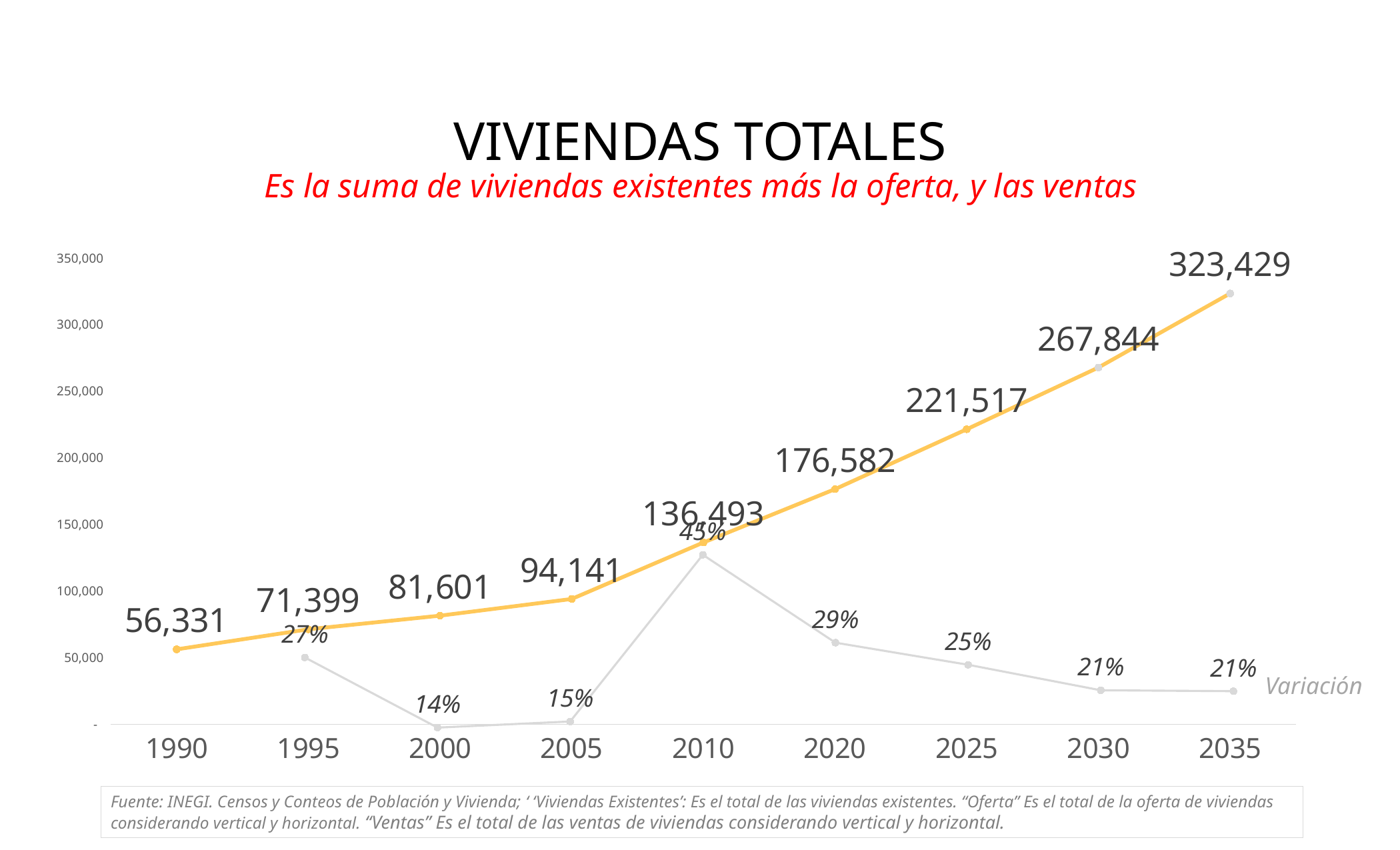
Which year has the highest value of viviendas totales? 2035 What is the value of viviendas totales for 1990? 56,331 Which is larger, the Variación for 2020 or the Variación for 2025? 2020 What type of chart is shown on the slide? Line chart What is the Variación percentage shown for 2000? 14% Which year has the lowest Variación percentage? 2000 What is the value of viviendas totales for 2010? 136,493 How many years are shown on the x axis? 9 What is the difference between the viviendas totales values for 2035 and 2030? 55,585 What is the Variación percentage shown for 2010? 45% Do the viviendas totales values rise or fall from 1990 to 2035? Rise What is the difference between the viviendas totales values for 2010 and 2005? 42,352